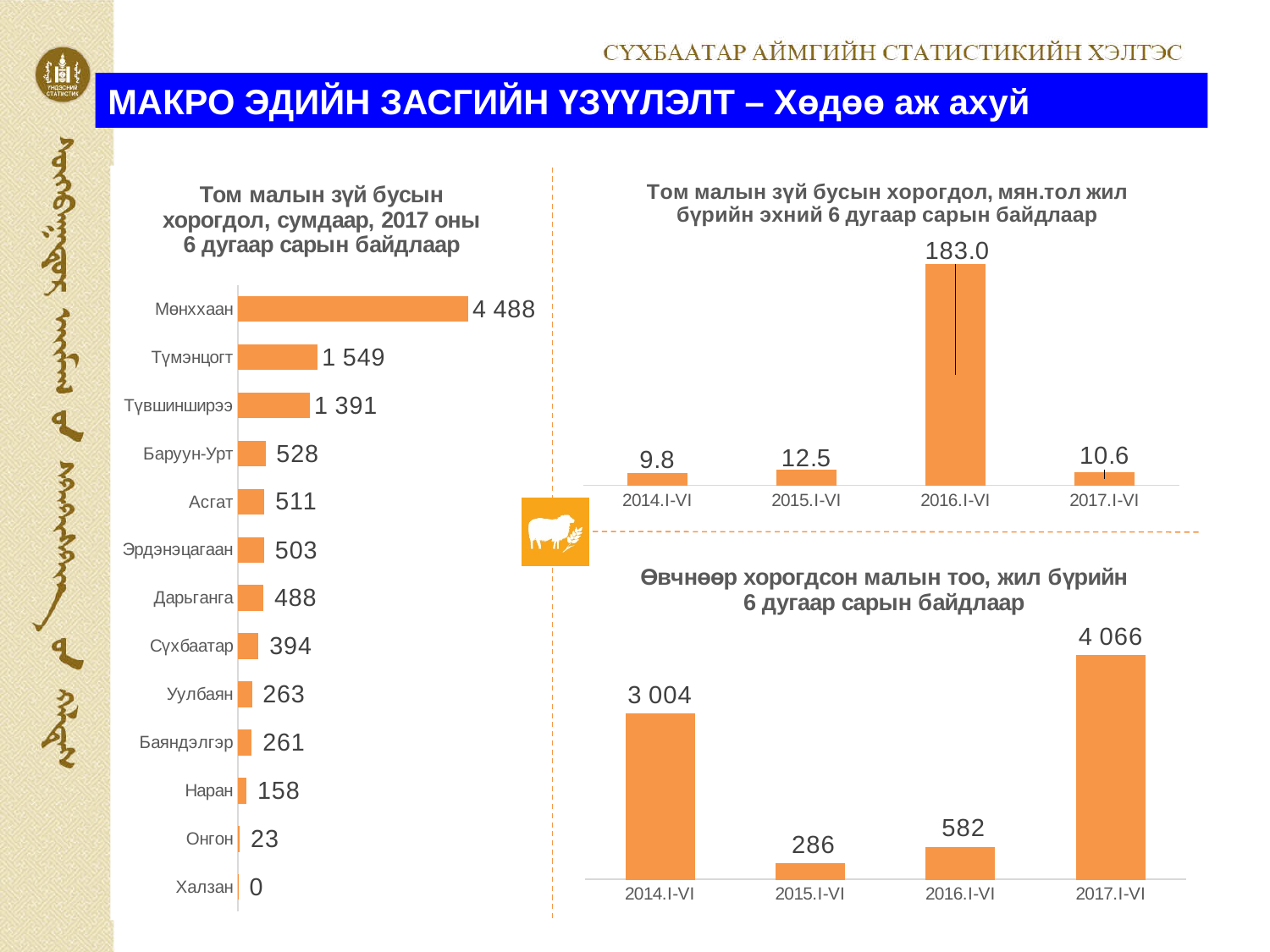
In the top right chart (Том малын зүй бусын хорогдол, мян.тол), which period has the highest value? 2016.I-VI In the left chart (Том малын зүй бусын хорогдол, сумдаар), what is the difference between Түмэнцогт and Түвшинширээ? 158 In the bottom right chart (Өвчнөөр хорогдсон малын тоо), which period has the highest value? 2017.I-VI In the left chart (Том малын зүй бусын хорогдол, сумдаар), which sum has the lowest value? Халзан In the left chart (Том малын зүй бусын хорогдол, сумдаар), which is larger, Баруун-Урт or Асгат? Баруун-Урт In the bottom right chart (Өвчнөөр хорогдсон малын тоо), what is the value for 2015.I-VI? 286 In the left chart (Том малын зүй бусын хорогдол, сумдаар), how many sums are listed? 13 What type of chart is the left chart (Том малын зүй бусын хорогдол, сумдаар)? Bar chart In the left chart (Том малын зүй бусын хорогдол, сумдаар), what is the value for Мөнххаан? 4 488 In the bottom right chart (Өвчнөөр хорогдсон малын тоо), what is the difference between 2017.I-VI and 2014.I-VI? 1 062 In the top right chart (Том малын зүй бусын хорогдол, мян.тол), what is the difference between 2015.I-VI and 2014.I-VI? 2.7 In the top right chart (Том малын зүй бусын хорогдол, мян.тол), what is the value for 2016.I-VI? 183.0